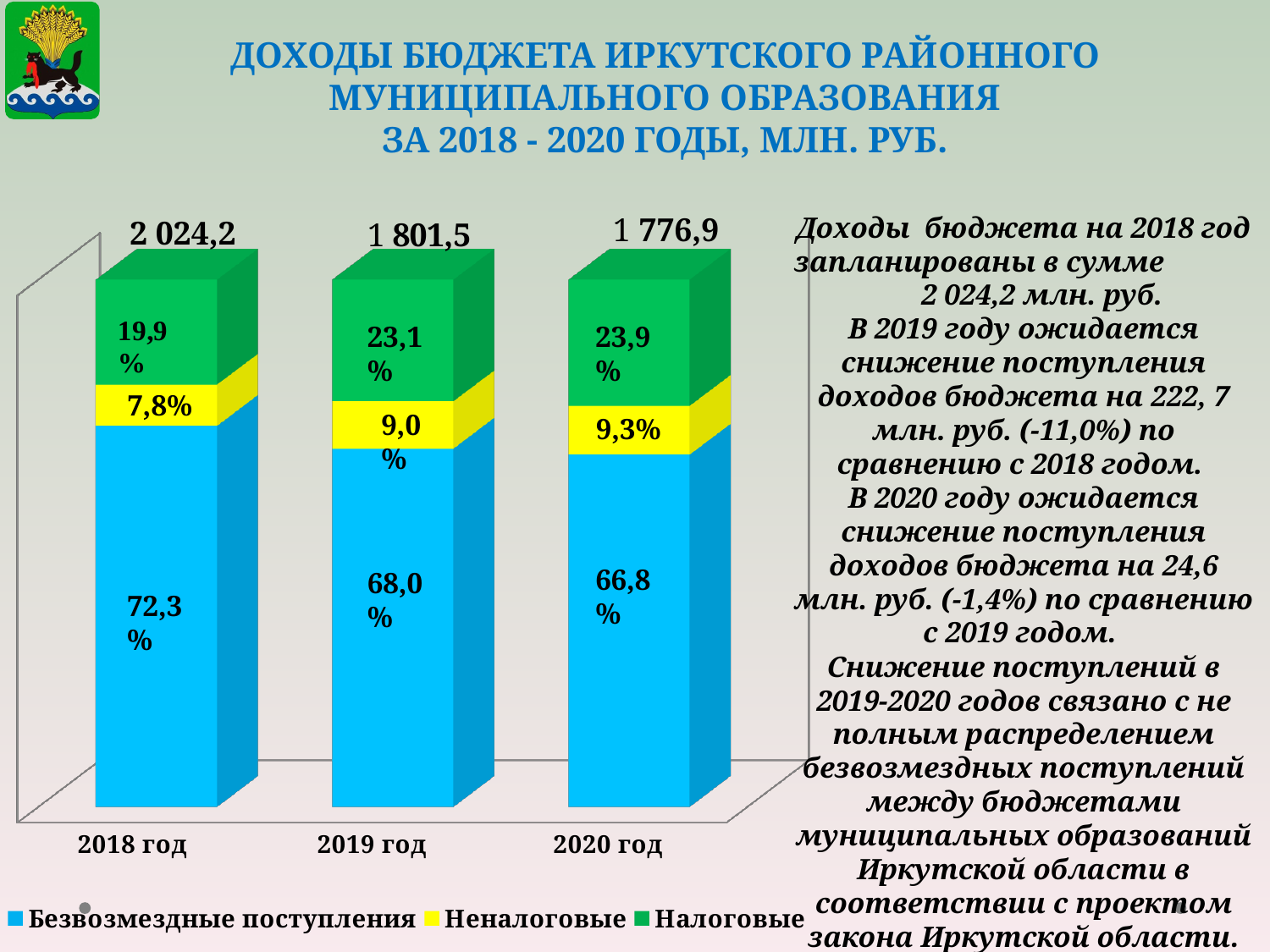
Which year has the highest total budget revenue? 2018 год How many years (categories) are shown on the x axis? 3 Does the share of Безвозмездные поступления rise or fall from 2018 год to 2020 год? fall Is the Налоговые share larger in 2018 год or in 2020 год? 2020 год Which year has the lowest total budget revenue? 2020 год What is the total budget revenue shown above the bar for 2020 год? 1 776,9 What is the total budget revenue shown above the bar for 2018 год? 2 024,2 What share of the 2020 год bar is labelled for Безвозмездные поступления? 66,8% What share of the 2019 год bar is labelled for Налоговые? 23,1% What share of the 2018 год bar is labelled for Неналоговые? 7,8% How many series does the legend list? 3 By how much does the total for 2018 год exceed the total for 2019 год? 222,7